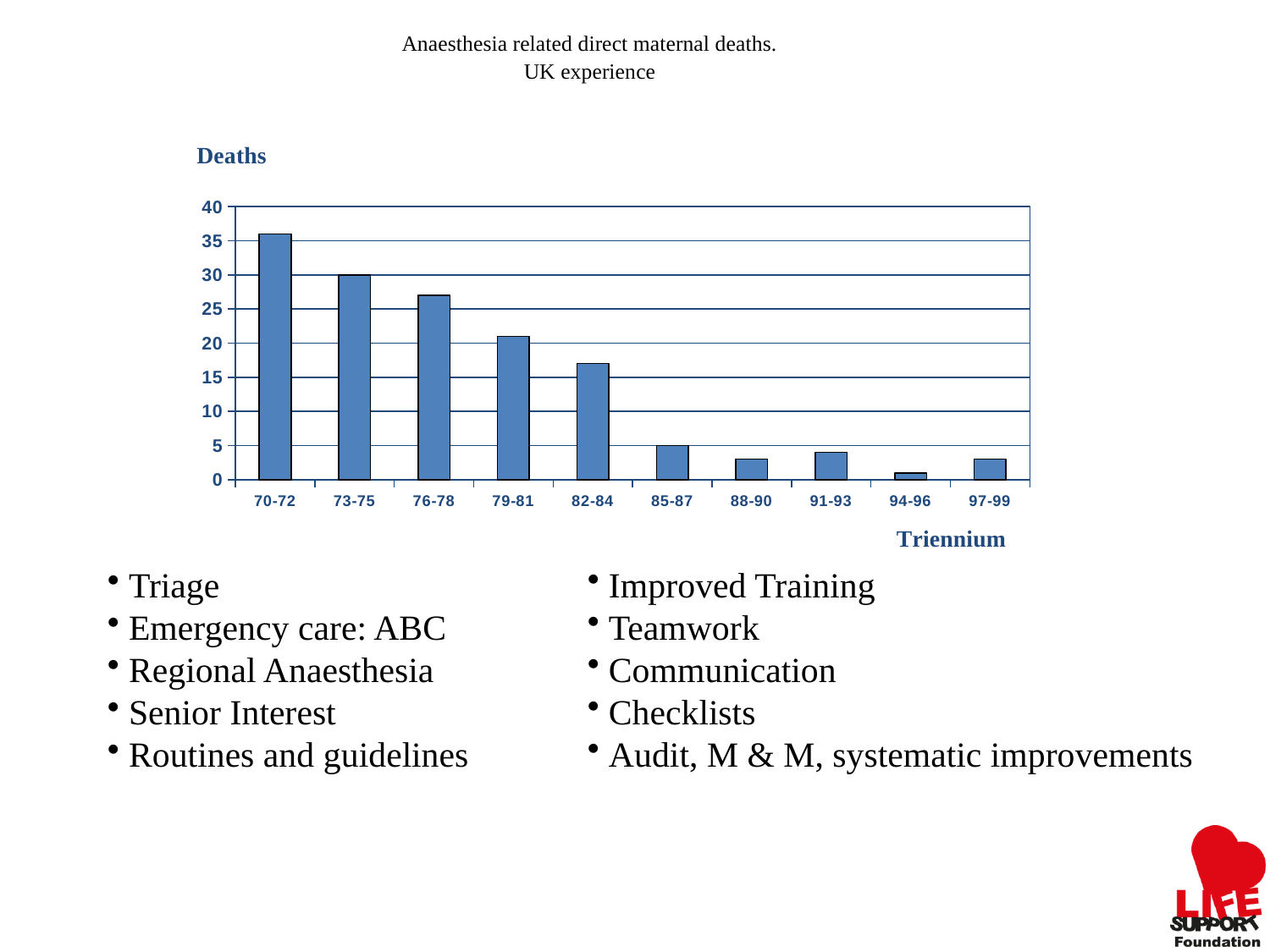
What is the label of the x axis of the chart? Triennium Which has more deaths, 91-93 or 94-96? 91-93 How many trienniums are shown on the x axis of the chart? 10 Do the values generally rise or fall from 70-72 to 97-99? fall Is the value for 88-90 greater or less than 5? less Is the value for 82-84 greater or less than 20? less Is the value for 76-78 greater or less than 25? greater Which triennium has the highest number of deaths? 70-72 What kind of chart is shown on the slide? bar chart Which triennium has the lowest number of deaths? 94-96 Which has more deaths, 79-81 or 82-84? 79-81